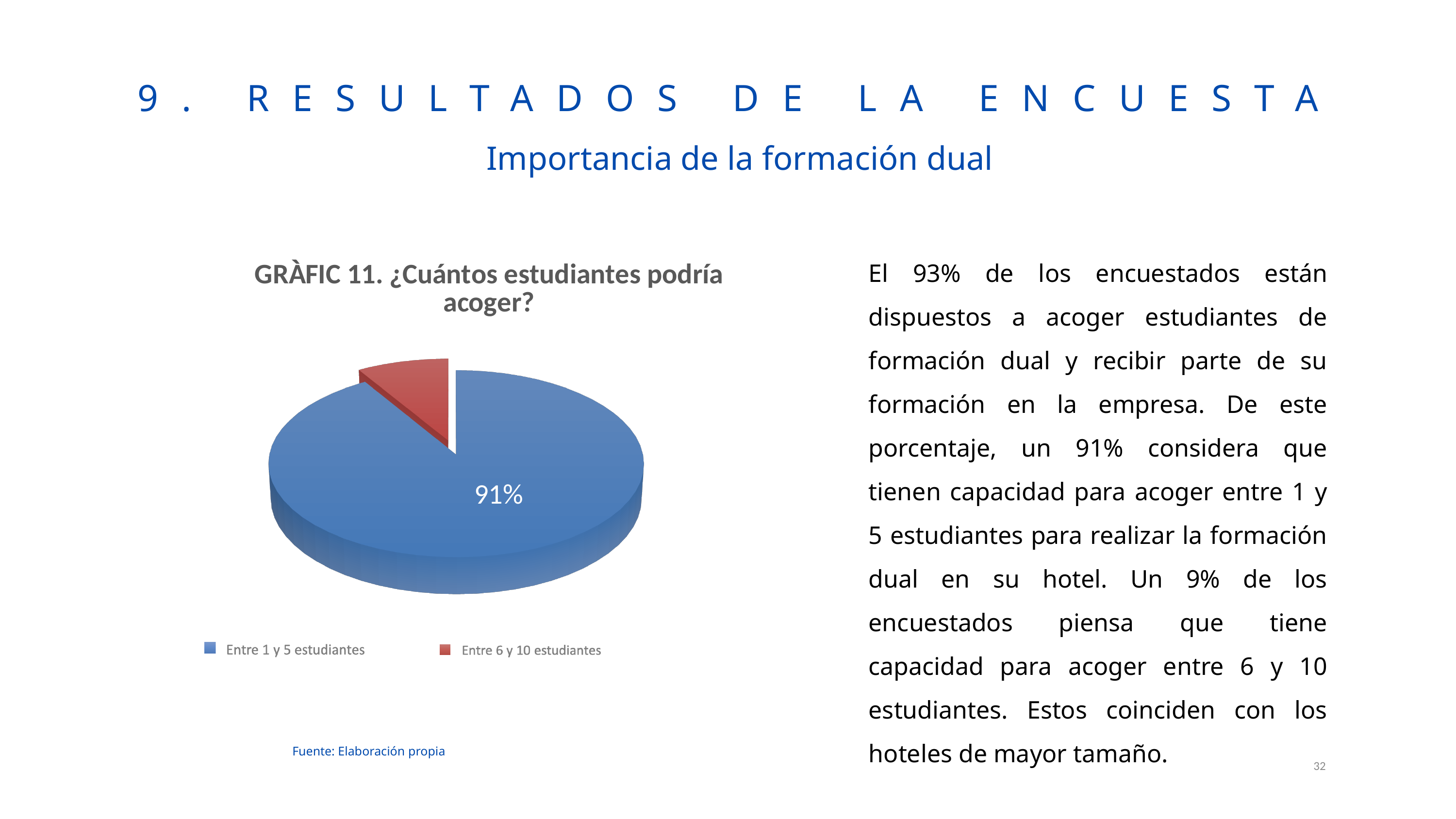
What colour is the slice for 'Entre 6 y 10 estudiantes'? red Is the share for 'Entre 1 y 5 estudiantes' greater or less than 50%? greater Which is larger, the slice for 'Entre 1 y 5 estudiantes' or the slice for 'Entre 6 y 10 estudiantes'? Entre 1 y 5 estudiantes Which category has the largest slice of the pie? Entre 1 y 5 estudiantes What kind of chart is shown on the slide? pie chart What share of the pie does 'Entre 1 y 5 estudiantes' represent? 91% How many entries does the legend list? 2 Which category has the smallest slice of the pie? Entre 6 y 10 estudiantes What percentage is shown for the 'Entre 1 y 5 estudiantes' slice? 91% How many categories does the pie chart have? 2 What is the title of the chart? GRÀFIC 11. ¿Cuántos estudiantes podría acoger?